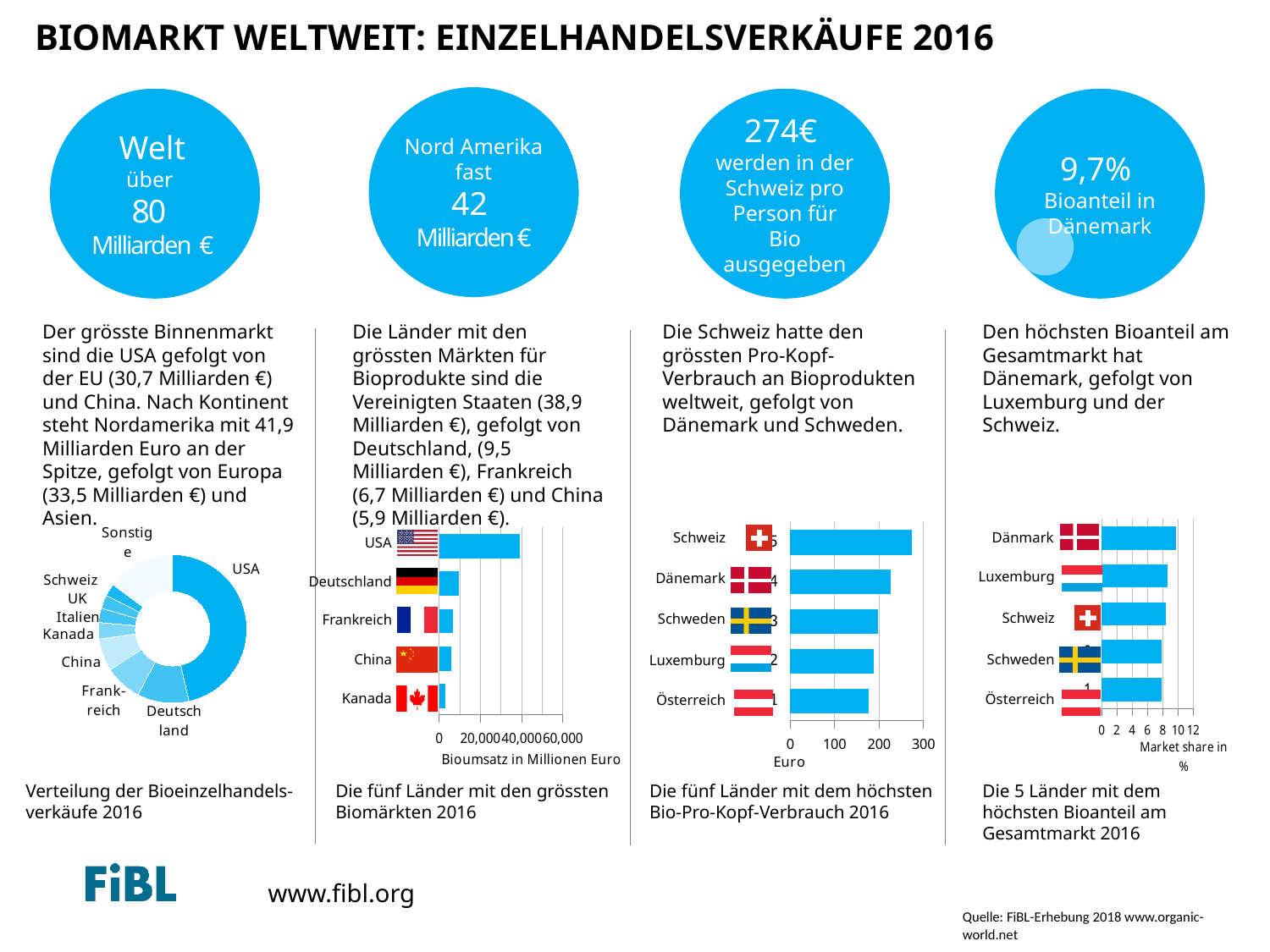
In the chart 'Die 5 Länder mit dem höchsten Bioanteil am Gesamtmarkt 2016', what is the x-axis label? Market share in % In the chart 'Die fünf Länder mit den grössten Biomärkten 2016', which country has the highest value? USA What kind of chart is 'Die fünf Länder mit den grössten Biomärkten 2016'? Bar chart What kind of chart is the chart titled 'Verteilung der Bioeinzelhandelsverkäufe 2016'? Pie (donut) chart In the chart 'Die fünf Länder mit den grössten Biomärkten 2016', which country has the lowest value? Kanada In the chart 'Die fünf Länder mit dem höchsten Bio-Pro-Kopf-Verbrauch 2016', is the value for Schweiz greater or less than 200? greater In the chart 'Die fünf Länder mit den grössten Biomärkten 2016', is the value for Deutschland greater or less than 20,000? less In the chart 'Die fünf Länder mit den grössten Biomärkten 2016', is the value for USA greater or less than 20,000? greater In the chart 'Verteilung der Bioeinzelhandelsverkäufe 2016', which country has the largest slice? USA In the chart 'Die fünf Länder mit dem höchsten Bio-Pro-Kopf-Verbrauch 2016', which is larger, Dänemark or Österreich? Dänemark In the chart 'Die fünf Länder mit dem höchsten Bio-Pro-Kopf-Verbrauch 2016', which country has the highest value? Schweiz How many categories are shown in the chart 'Verteilung der Bioeinzelhandelsverkäufe 2016'? 9